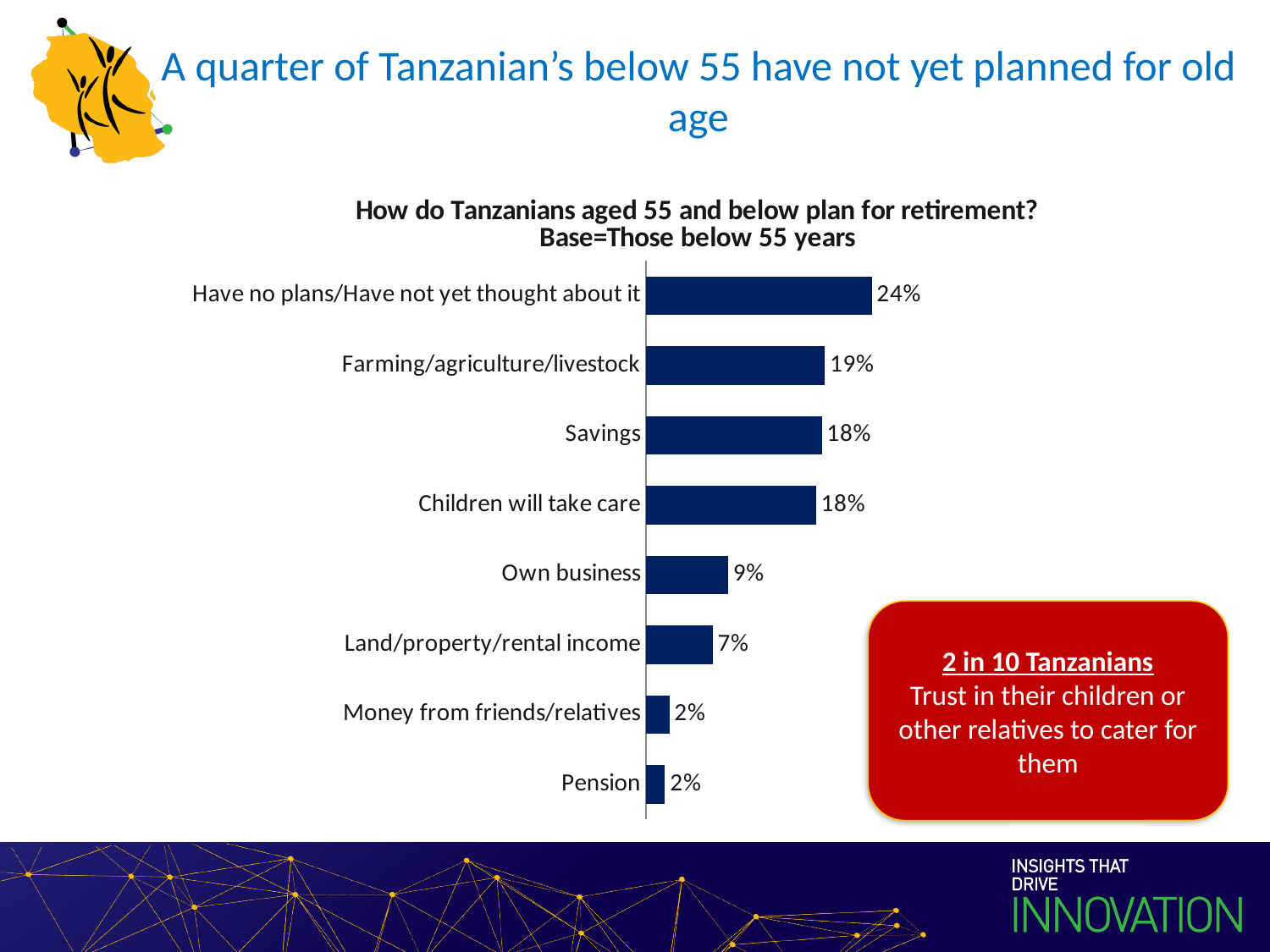
What percentage of Tanzanians below 55 have no plans or have not yet thought about retirement? 24% What is the value for Own business? 9% Which is larger, the value for Own business or the value for Land/property/rental income? Own business Which category has the highest value? Have no plans/Have not yet thought about it What is the value for Farming/agriculture/livestock? 19% What kind of chart is shown on the slide? Bar chart How many categories are shown in the chart? 8 What is the value for Land/property/rental income? 7% What value is shown for Pension? 2% What is the difference between the values for Savings and Own business? 9% What is the title of the chart? How do Tanzanians aged 55 and below plan for retirement? Base=Those below 55 years What is the difference between the values for Have no plans/Have not yet thought about it and Farming/agriculture/livestock? 5%